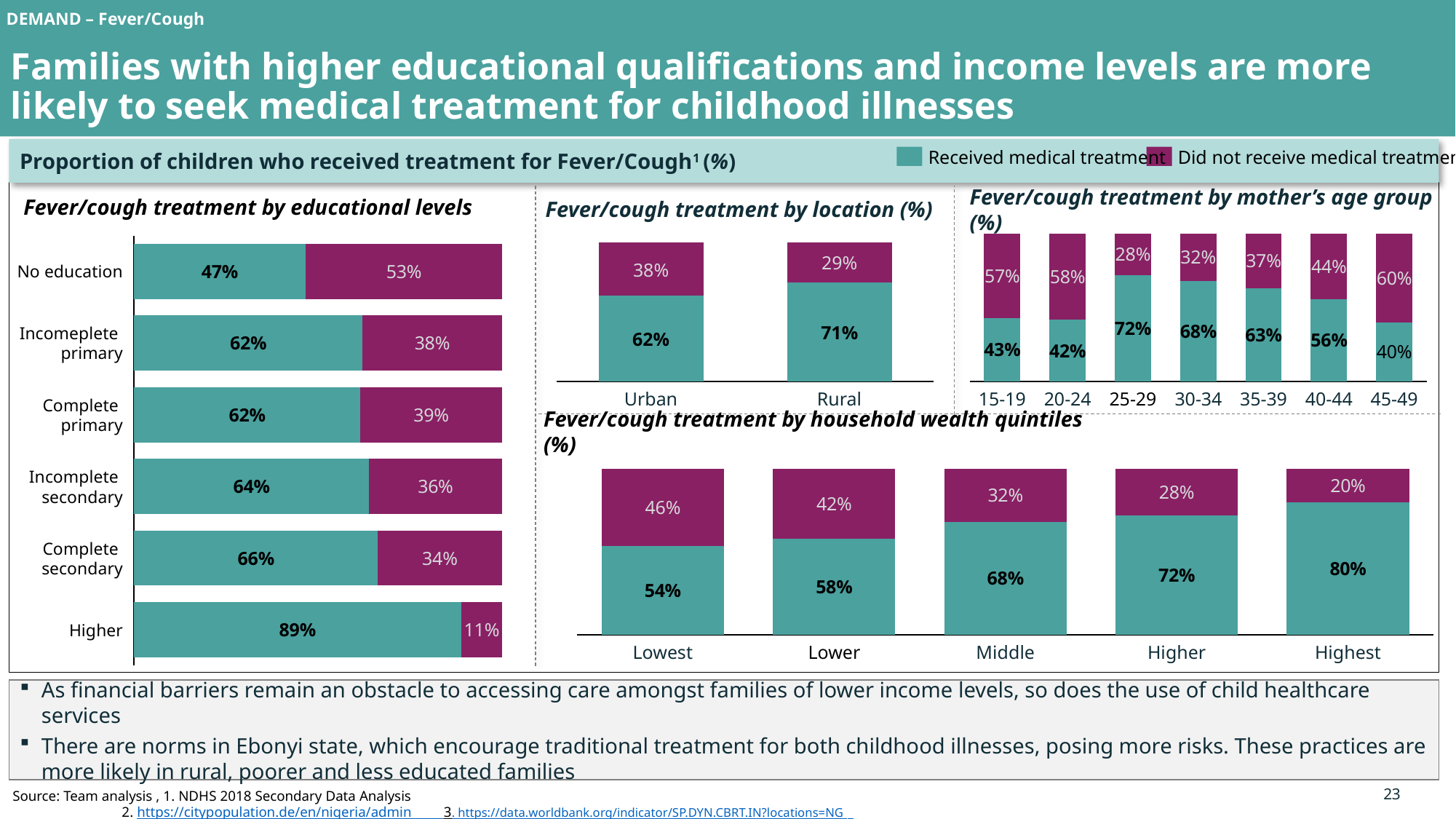
How many series does the legend at the top of the slide list? 2 In the 'Fever/cough treatment by educational levels' chart, what percentage of children of mothers with no education received medical treatment? 47% In the 'Fever/cough treatment by mother's age group' chart, what percentage of children of mothers aged 25-29 received medical treatment? 72% In the 'Fever/cough treatment by educational levels' chart, what is the difference in the 'Received medical treatment' share between Higher and No education? 42 percentage points In the 'Fever/cough treatment by household wealth quintiles' chart, do the 'Received medical treatment' values rise or fall from Lowest to Highest? Rise What type of chart is the 'Fever/cough treatment by educational levels' chart? Stacked bar chart In the 'Fever/cough treatment by educational levels' chart, which educational level has the highest share of children who received medical treatment? Higher In the 'Fever/cough treatment by household wealth quintiles' chart, what percentage of children in the Middle quintile did not receive medical treatment? 32% In the 'Fever/cough treatment by location' chart, which location has the larger share of children who did not receive medical treatment, Urban or Rural? Urban How many age groups are shown in the 'Fever/cough treatment by mother's age group' chart? 7 In the 'Fever/cough treatment by mother's age group' chart, which age group has the lowest share of children who received medical treatment? 45-49 In the 'Fever/cough treatment by location' chart, what percentage of rural children received medical treatment? 71%